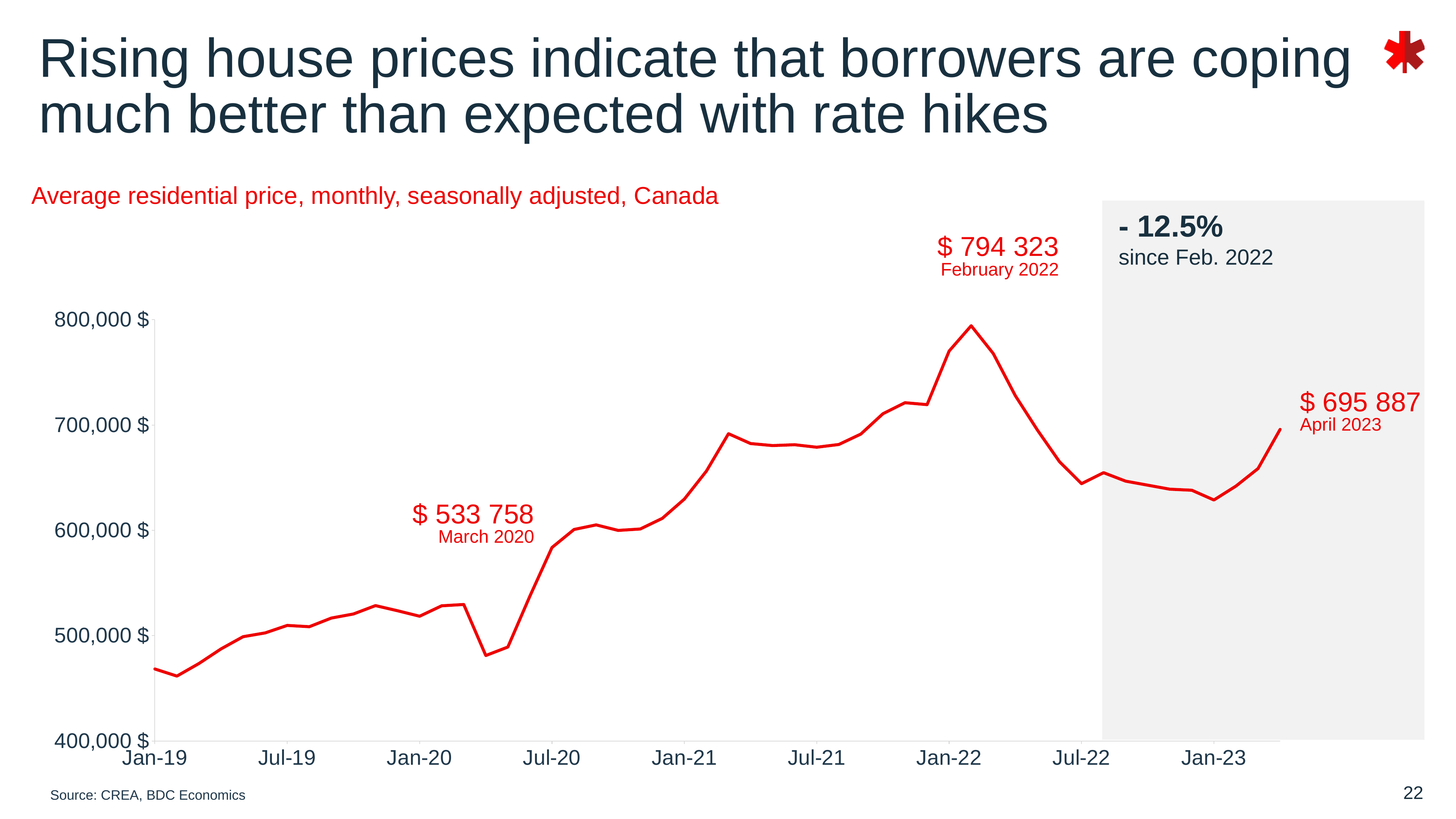
Does the line rise or fall between February 2022 and Jul-22? fall What is the average residential price labelled for March 2020? $ 533 758 Which is larger, the price in February 2022 or the price in April 2023? February 2022 What is the average residential price labelled for February 2022? $ 794 323 Is the value at Jan-19 greater or less than 500,000 $? less Is the value at Jan-22 greater or less than 700,000 $? greater What percentage change since Feb. 2022 is annotated in the shaded area? - 12.5% What is the difference between the February 2022 price and the April 2023 price? $ 98 436 What is the difference between the February 2022 price and the March 2020 price? $ 260 565 What kind of chart is shown on the slide? line chart In which month does the line reach its highest point? February 2022 What is the average residential price labelled for April 2023? $ 695 887